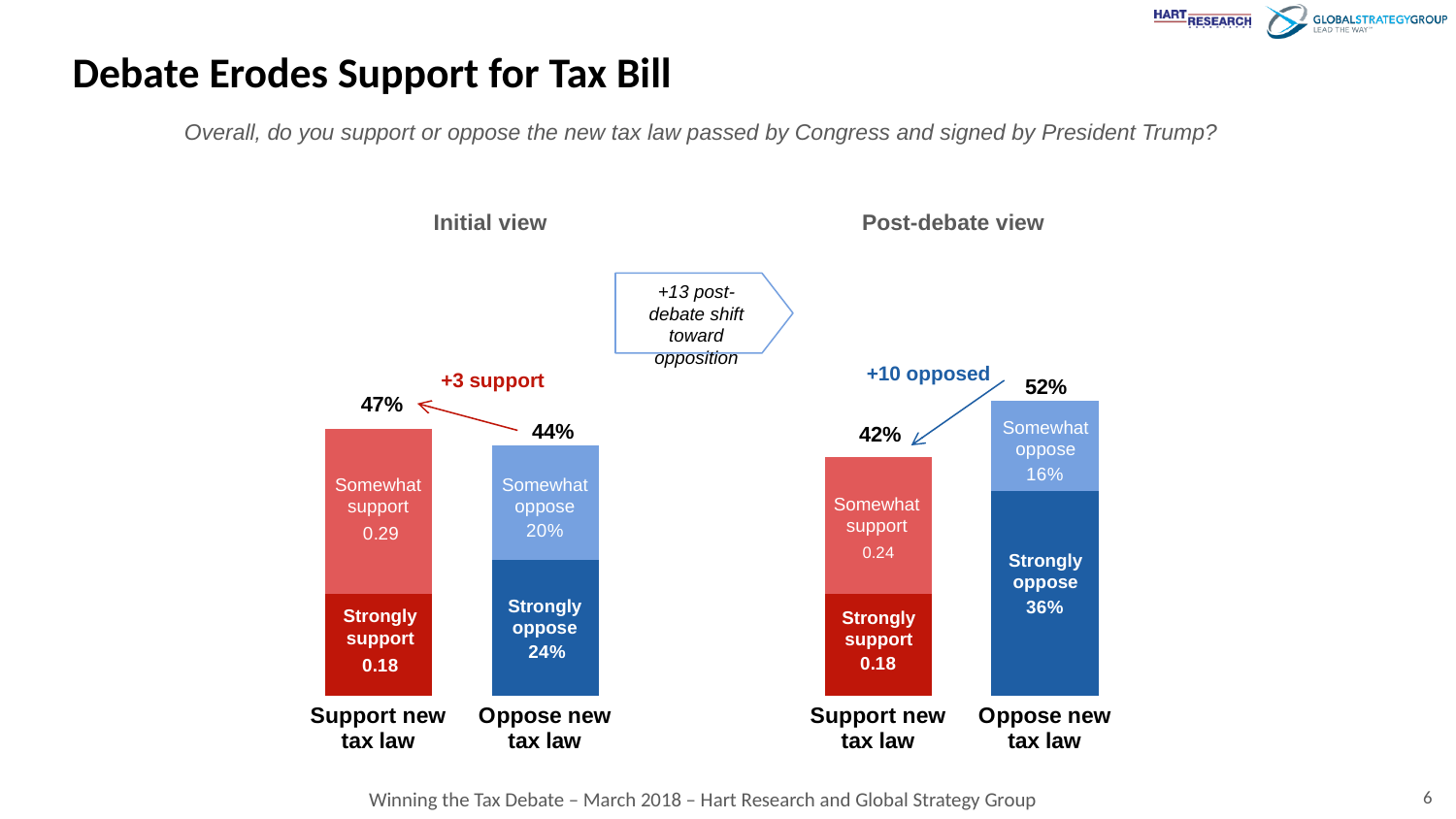
In the Post-debate view chart, what is the difference between Strongly oppose and Somewhat oppose? 20% In the Post-debate view chart, which bar has the higher total, Support new tax law or Oppose new tax law? Oppose new tax law What kind of chart is the Post-debate view chart? Stacked bar chart What is the title of the chart on the left side of the slide? Initial view In the Post-debate view chart, what is the value for Somewhat support? 0.24 In the Post-debate view chart, what is the value for Strongly oppose? 36% In the Initial view chart, what is the value for Strongly support? 0.18 In the Initial view chart, what is the value for Somewhat oppose? 20% How many bars are in the Initial view chart? 2 In the Post-debate view chart, what is the total shown for the Oppose new tax law bar? 52% In the Initial view chart, what is the total shown for the Support new tax law bar? 47% In the Initial view chart, which bar has the higher total, Support new tax law or Oppose new tax law? Support new tax law